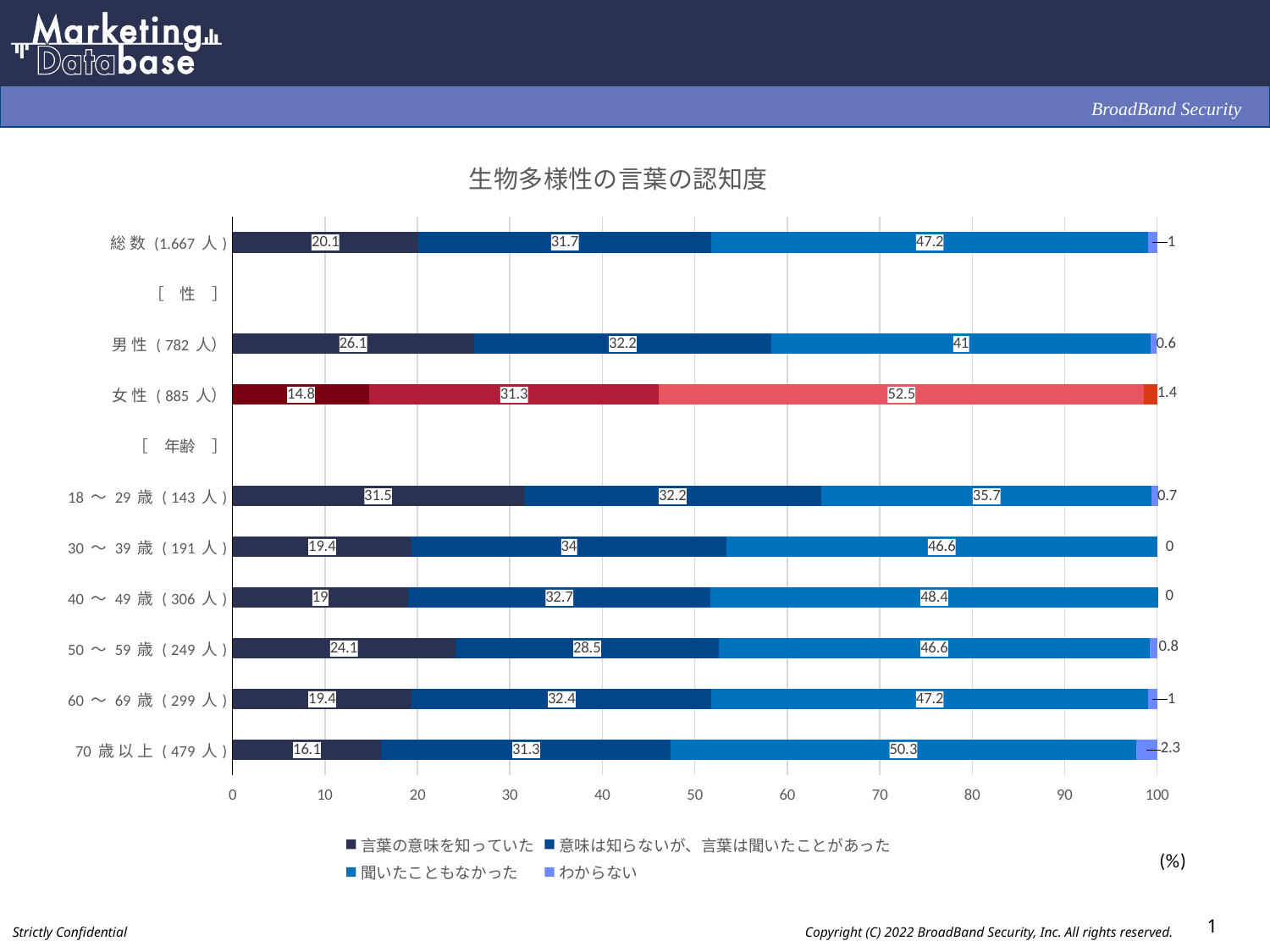
Which is larger for 聞いたこともなかった: 男性 (782人) or 女性 (885人)? 女性 (885人) What is the title of the chart? 生物多様性の言葉の認知度 What is the value of 言葉の意味を知っていた for 総数 (1,667人)? 20.1 How many series does the legend list? 4 What is the value of 聞いたこともなかった for 女性 (885人)? 52.5 Which age groups have a value of 0 for わからない? 30～39歳 (191人) and 40～49歳 (306人) Which age group has the highest value for 言葉の意味を知っていた? 18～29歳 (143人) What is the value of わからない for 70歳以上 (479人)? 2.3 Which category has the lowest value for 言葉の意味を知っていた? 女性 (885人) What is the difference between 男性 (782人) and 女性 (885人) for 言葉の意味を知っていた? 11.3 What type of chart is shown on the slide? Stacked bar chart What is the value of 意味は知らないが、言葉は聞いたことがあった for 30～39歳 (191人)? 34